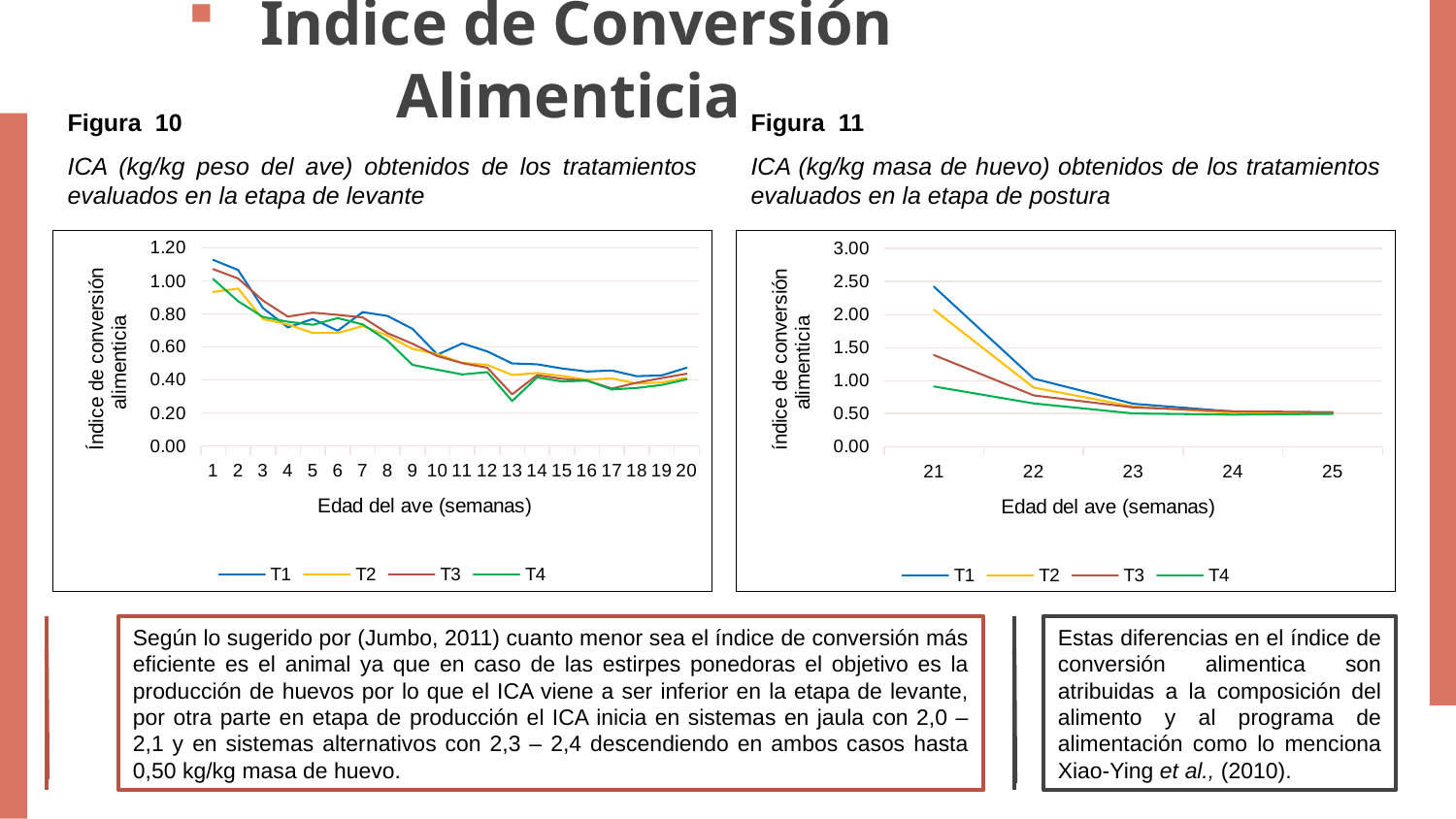
What is the x-axis title of Figura 10? Edad del ave (semanas) In Figura 11, which series has the lowest value at week 21? T4 In Figura 11, which series has the highest value at week 21? T1 How many weeks (x-axis categories) are plotted in Figura 11? 5 In Figura 11, is the value for T1 at week 21 greater or less than 2.00? greater What kind of chart is Figura 10? line chart In Figura 11, do the values for T1 rise or fall from week 21 to week 25? fall In Figura 11, is the value for T4 at week 21 greater or less than 1.00? less How many weeks (x-axis categories) are plotted in Figura 10? 20 What kind of chart is Figura 11? line chart How many series does the legend of Figura 11 list? 4 In Figura 10, do the values for T1 generally rise or fall from week 1 to week 20? fall